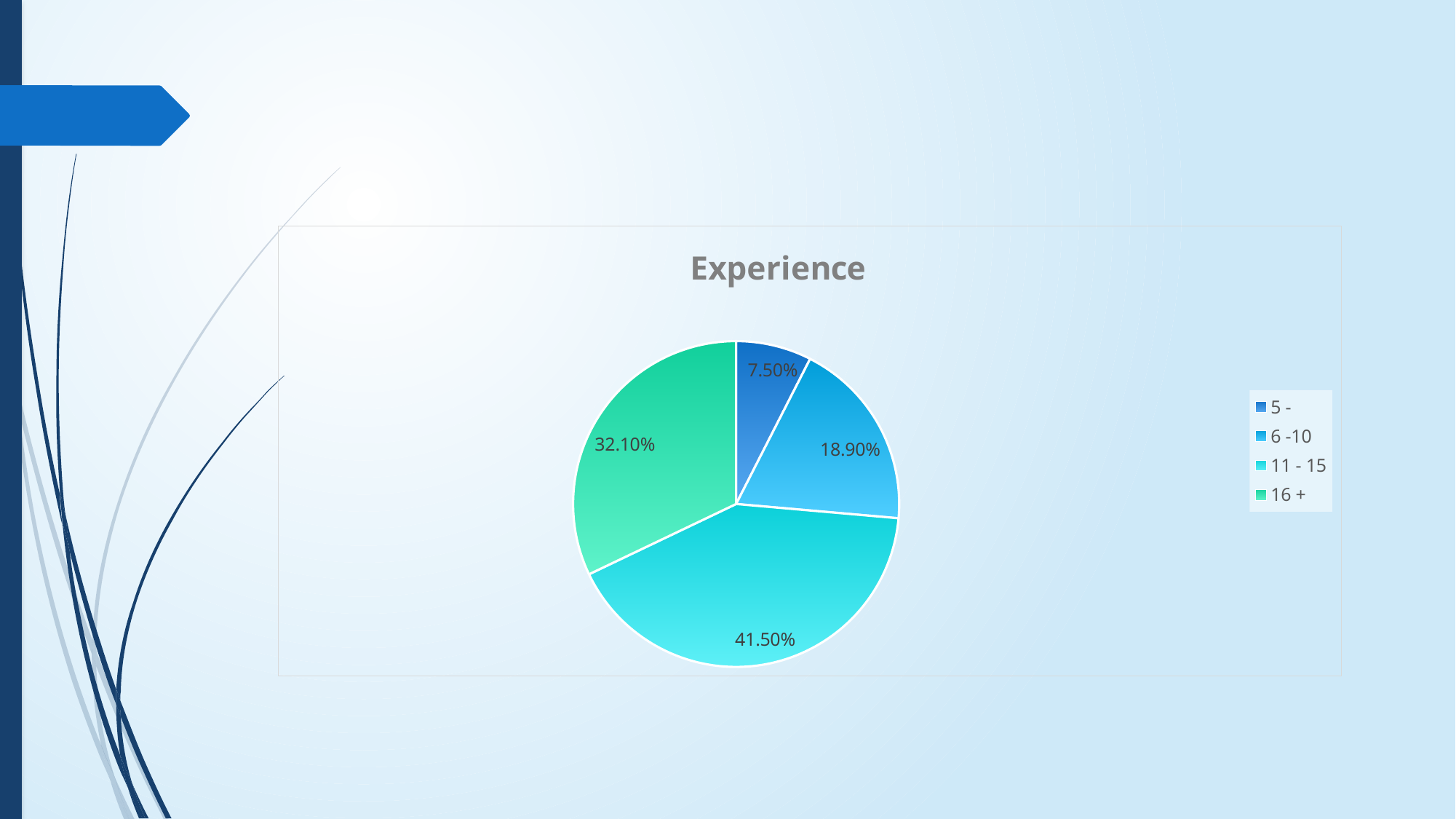
Which category has the smallest slice of the pie? 5 - What share of the pie does the "6 -10" slice represent? 18.90% Which category has the largest slice of the pie? 11 - 15 What share of the pie does the "11 - 15" slice represent? 41.50% What is the difference between the "16 +" share and the "6 -10" share? 13.20% Which is larger, the "16 +" slice or the "6 -10" slice? 16 + What is the combined share of the "5 -" and "6 -10" slices? 26.40% What share of the pie does the "16 +" slice represent? 32.10% What share of the pie does the "5 -" slice represent? 7.50% How many categories does the legend list? 4 What kind of chart is shown on the slide? pie chart What is the title of the chart? Experience